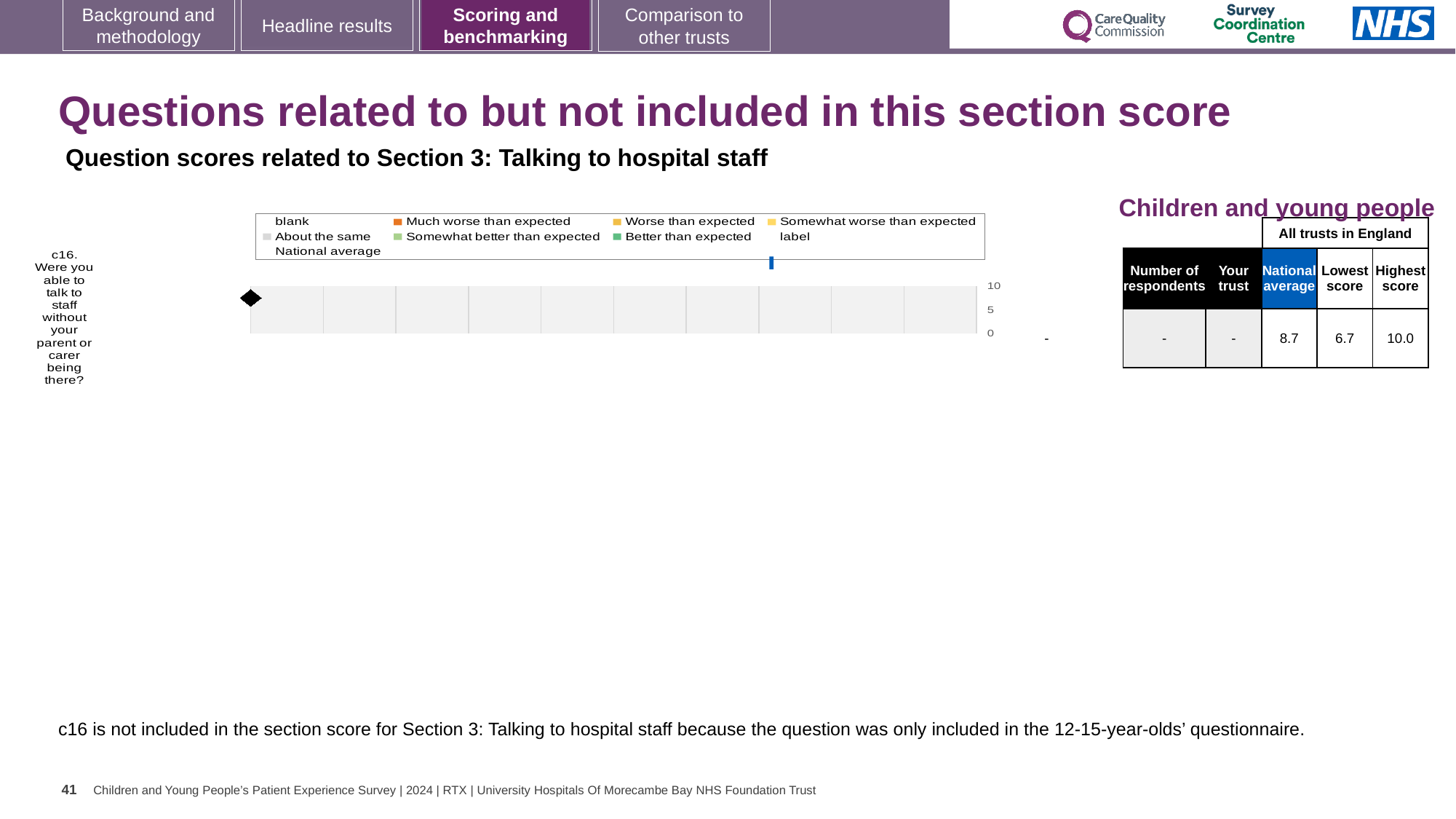
In the Children and young people table, what is the National average score for c16? 8.7 Which question is plotted on the chart? c16. Were you able to talk to staff without your parent or carer being there? Is the National average for c16 greater or less than 5? greater What is the difference between the Highest score and the Lowest score for c16 in the table? 3.3 In the Children and young people table, what is shown for Your trust score for c16? - What is the highest value shown on the chart's score axis? 10 In the Children and young people table, what is the Lowest score for c16? 6.7 In the Children and young people table, what is the Highest score for c16? 10.0 What kind of chart is shown on the slide? bar chart How many questions (categories) are plotted on the chart? 1 Which is larger for c16: the National average or the Lowest score? National average